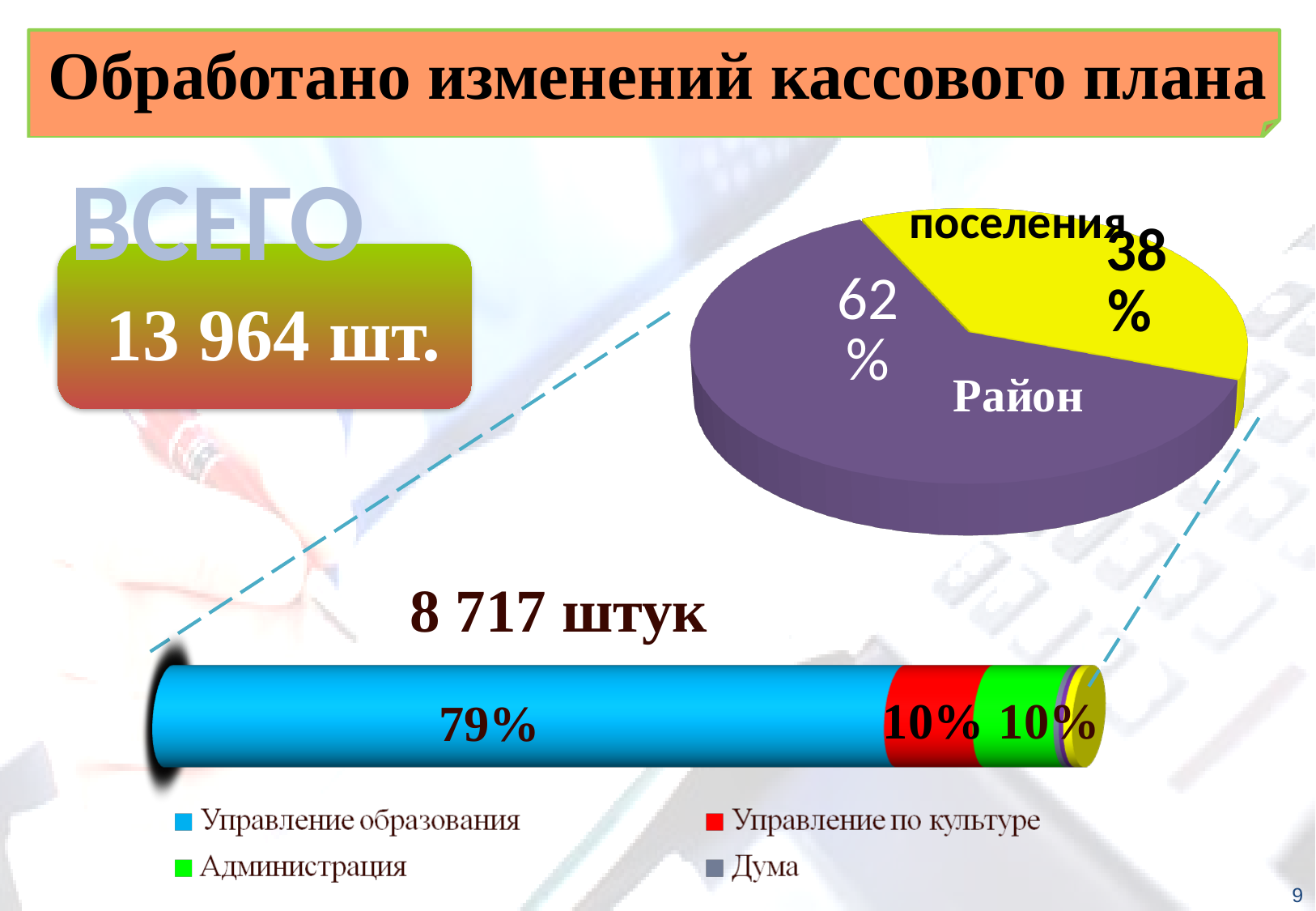
In the stacked bar chart at the bottom, which colour represents Администрация? green In the stacked bar chart at the bottom, what share does Управление по культуре have? 10% What kind of chart is the chart at the bottom of the slide? bar chart In the stacked bar chart at the bottom, what share does Управление образования have? 79% In the stacked bar chart at the bottom, which segment is the largest? Управление образования In the pie chart, which slice is larger, Район or поселения? Район In the pie chart, what share does Район have? 62% In the pie chart, what share does поселения have? 38% What kind of chart is the chart in the top right of the slide? pie chart How many slices does the pie chart have? 2 In the pie chart, what is the difference in percentage points between Район and поселения? 24 How many series does the legend of the stacked bar chart at the bottom list? 4